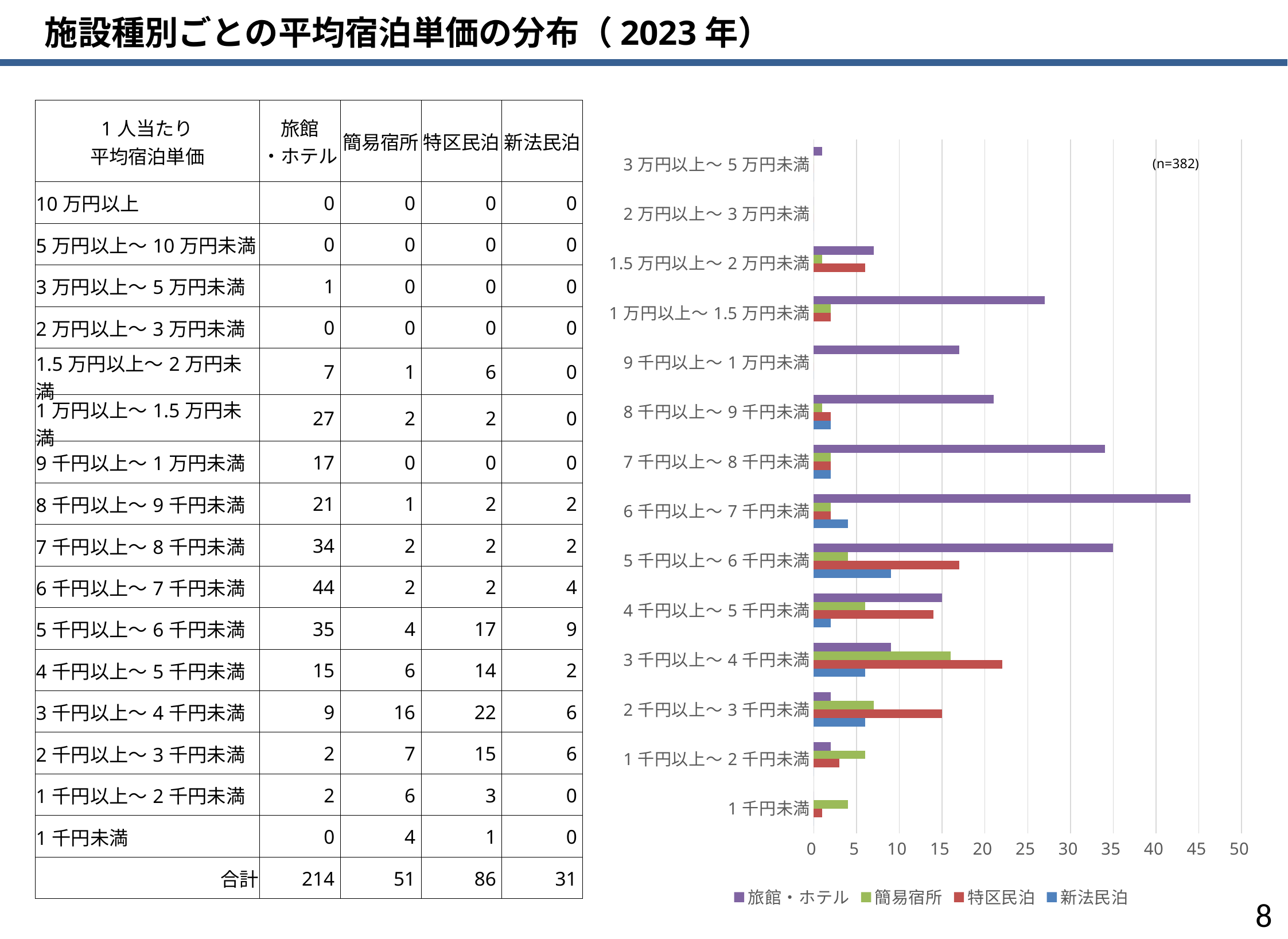
How many series does the chart legend list? 4 What is the value for 旅館・ホテル in the 6千円以上〜7千円未満 category? 44 Which price category has the highest value for 簡易宿所? 3千円以上〜4千円未満 What kind of chart is shown on the right of the slide? bar chart Is the value for 旅館・ホテル in the 7千円以上〜8千円未満 category greater or less than 30? greater Which price category has the highest value for 新法民泊? 5千円以上〜6千円未満 How many price categories are shown on the chart's vertical axis? 14 What is the value for 特区民泊 in the 3千円以上〜4千円未満 category? 22 In the 3千円以上〜4千円未満 category, which is larger: 簡易宿所 or 特区民泊? 特区民泊 Which price category has the highest value for 旅館・ホテル? 6千円以上〜7千円未満 What is the difference between the 旅館・ホテル values for 6千円以上〜7千円未満 and 5千円以上〜6千円未満? 9 Is the value for 特区民泊 in the 5千円以上〜6千円未満 category greater or less than 20? less